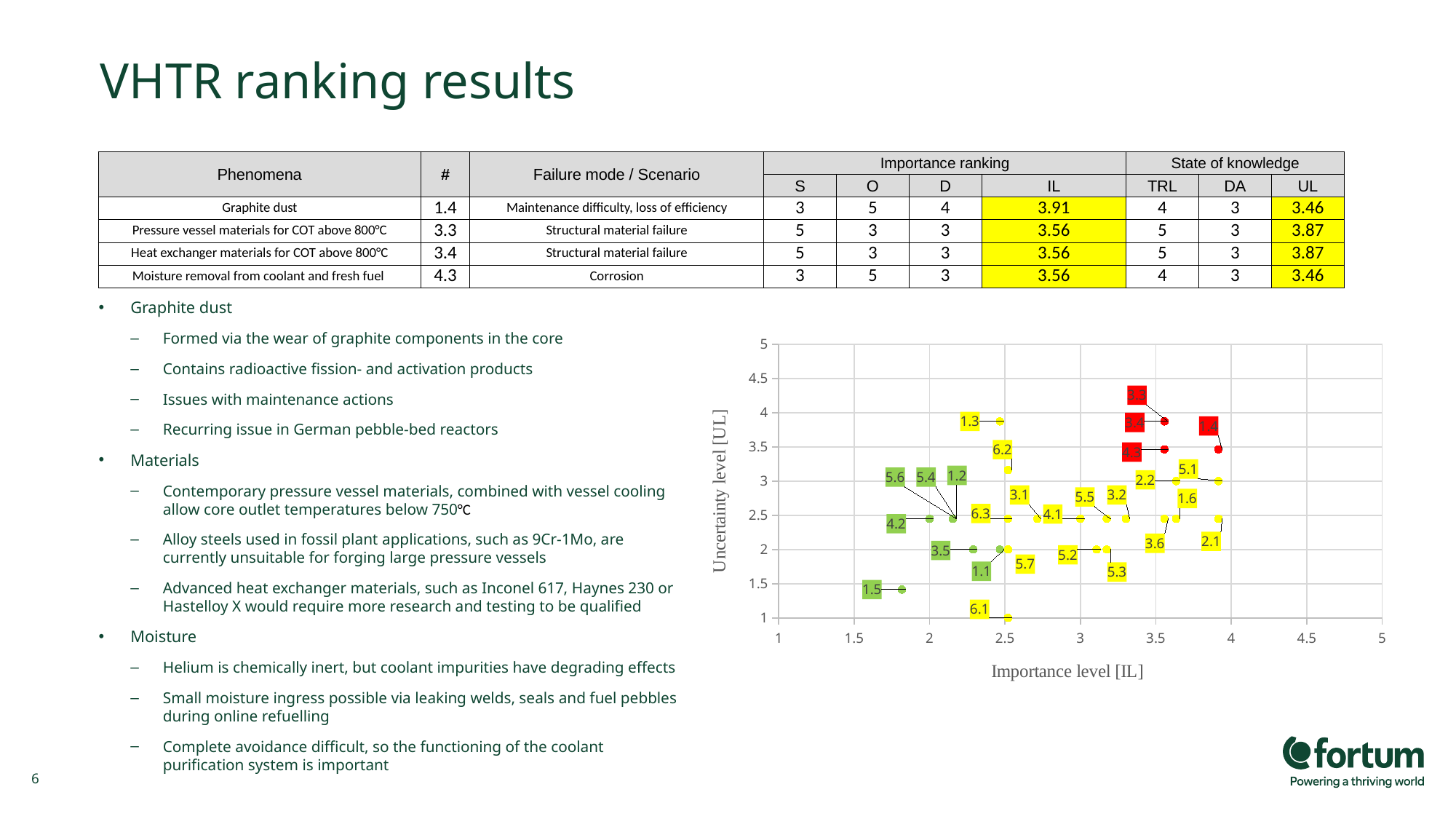
Which point has the lowest importance level (IL) in the chart? 1.5 Which point has a higher uncertainty level, 1.3 or 6.1? 1.3 Which point has a higher importance level, 1.4 or 1.3? 1.4 What kind of chart is shown on the slide? scatter chart Is the uncertainty level for point 6.1 greater or less than 1.5? less What is the label of the y axis of the chart? Uncertainty level [UL] Is the importance level for point 1.5 greater or less than 2? less What is the label of the x axis of the chart? Importance level [IL] Is the uncertainty level for point 1.3 greater or less than 3.5? greater Which point has the lowest uncertainty level (UL) in the chart? 6.1